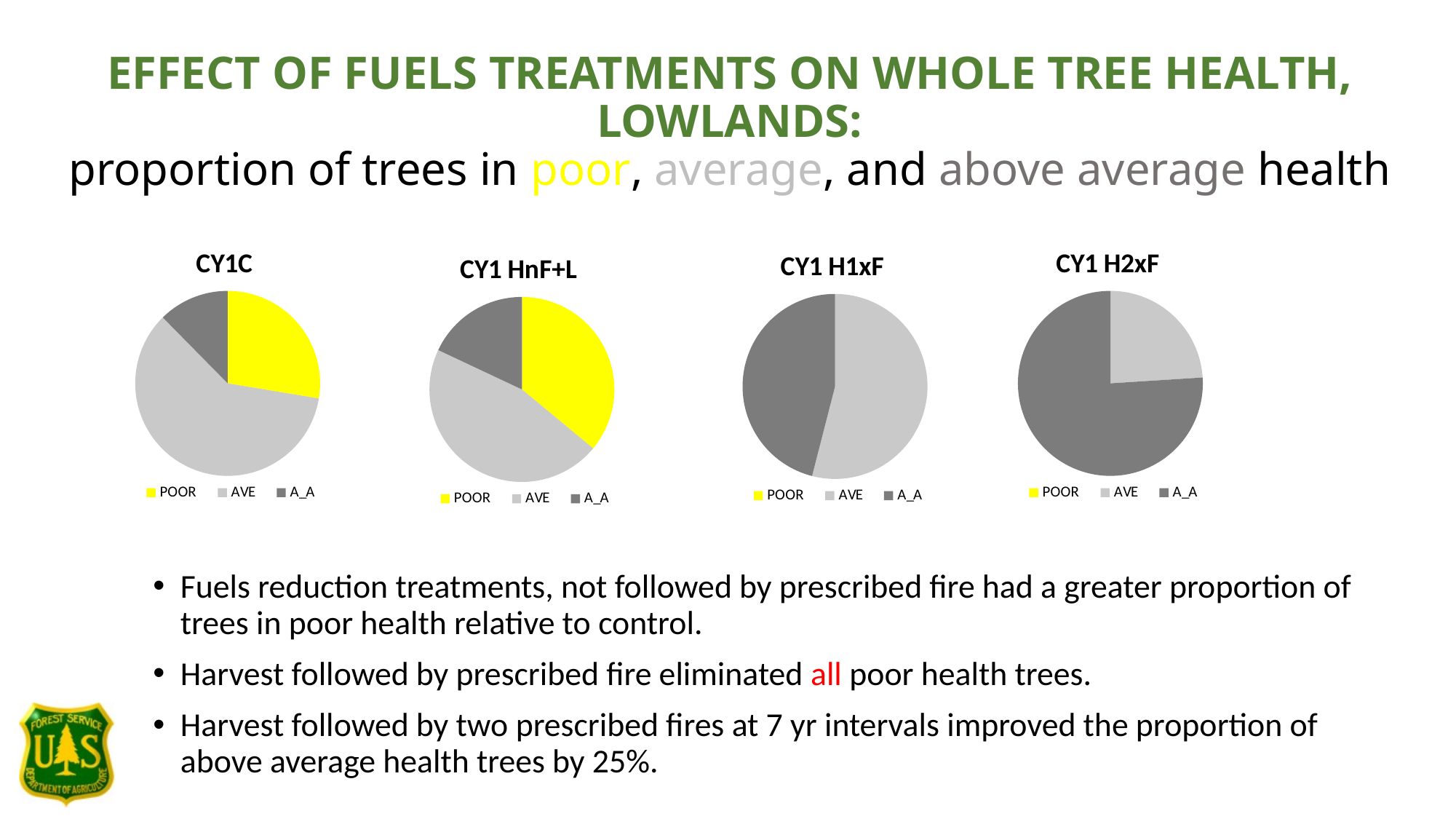
How many pie charts are shown on the slide? 4 Which colour represents the POOR category in the legends? yellow What kind of chart is the CY1C chart? pie chart In the CY1 HnF+L chart, which category has the smallest slice? A_A How many slices are visible in the CY1 H1xF pie chart? 2 In the CY1 H2xF chart, which slice is larger, AVE or A_A? A_A How many categories does the legend of the CY1C chart list? 3 In the CY1C chart, which category has the smallest slice? A_A In the CY1C chart, which category has the largest slice? AVE In the CY1 HnF+L chart, which category has the largest slice? AVE In the CY1 H2xF chart, which category has the largest slice? A_A In the CY1C chart, which slice is larger, POOR or A_A? POOR